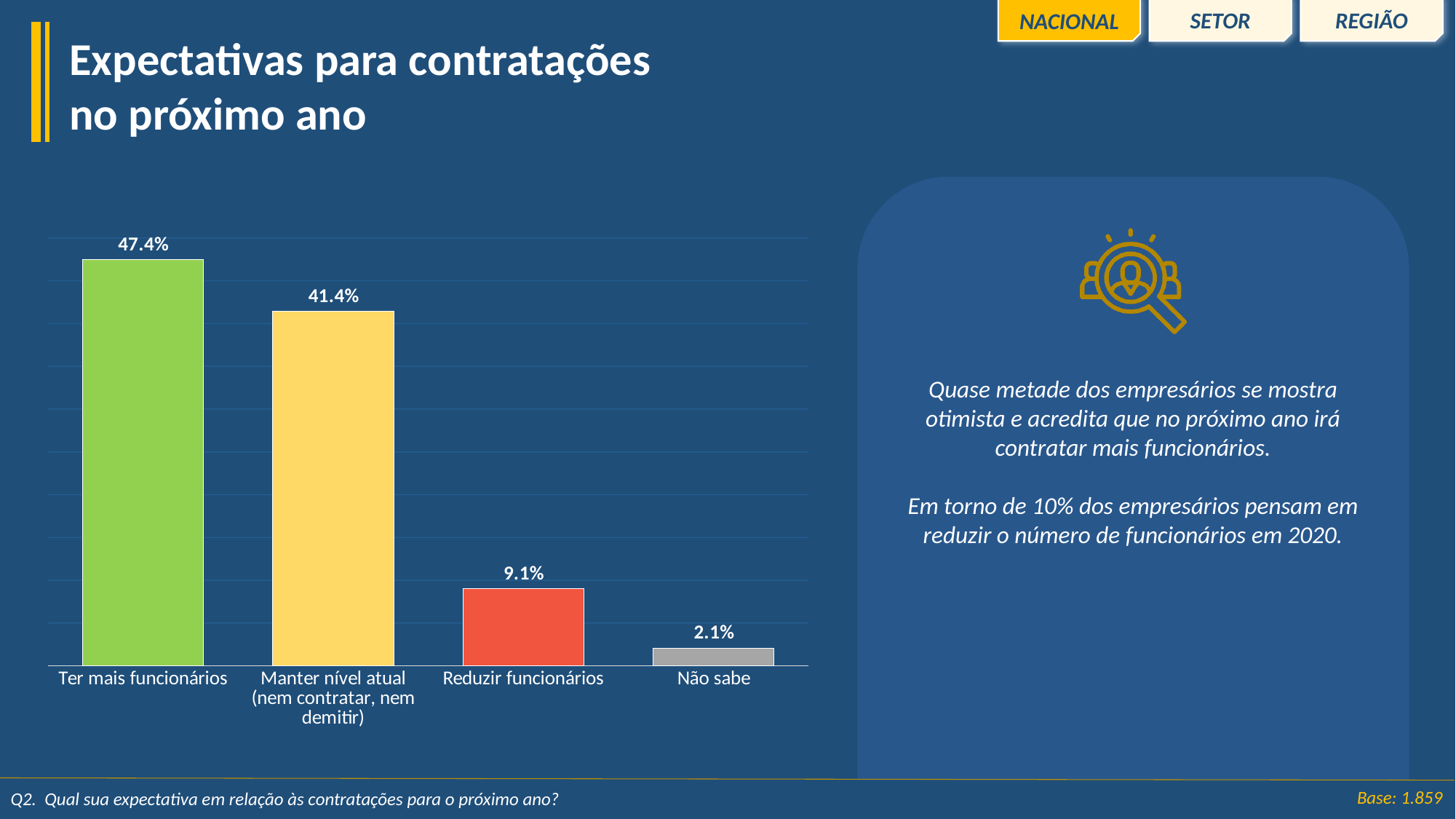
What colour is the bar for 'Reduzir funcionários'? Red What is the value for 'Não sabe'? 2.1% What is the value for 'Reduzir funcionários'? 9.1% What kind of chart is shown on the slide? Bar chart What is the difference between 'Reduzir funcionários' and 'Não sabe'? 7.0% What is the difference between 'Ter mais funcionários' and 'Manter nível atual (nem contratar, nem demitir)'? 6.0% What is the value for 'Manter nível atual (nem contratar, nem demitir)'? 41.4% Which category has the highest value? Ter mais funcionários How many categories are shown in the chart? 4 Which category has the lowest value? Não sabe Which is larger: 'Reduzir funcionários' or 'Não sabe'? Reduzir funcionários What is the value for 'Ter mais funcionários'? 47.4%